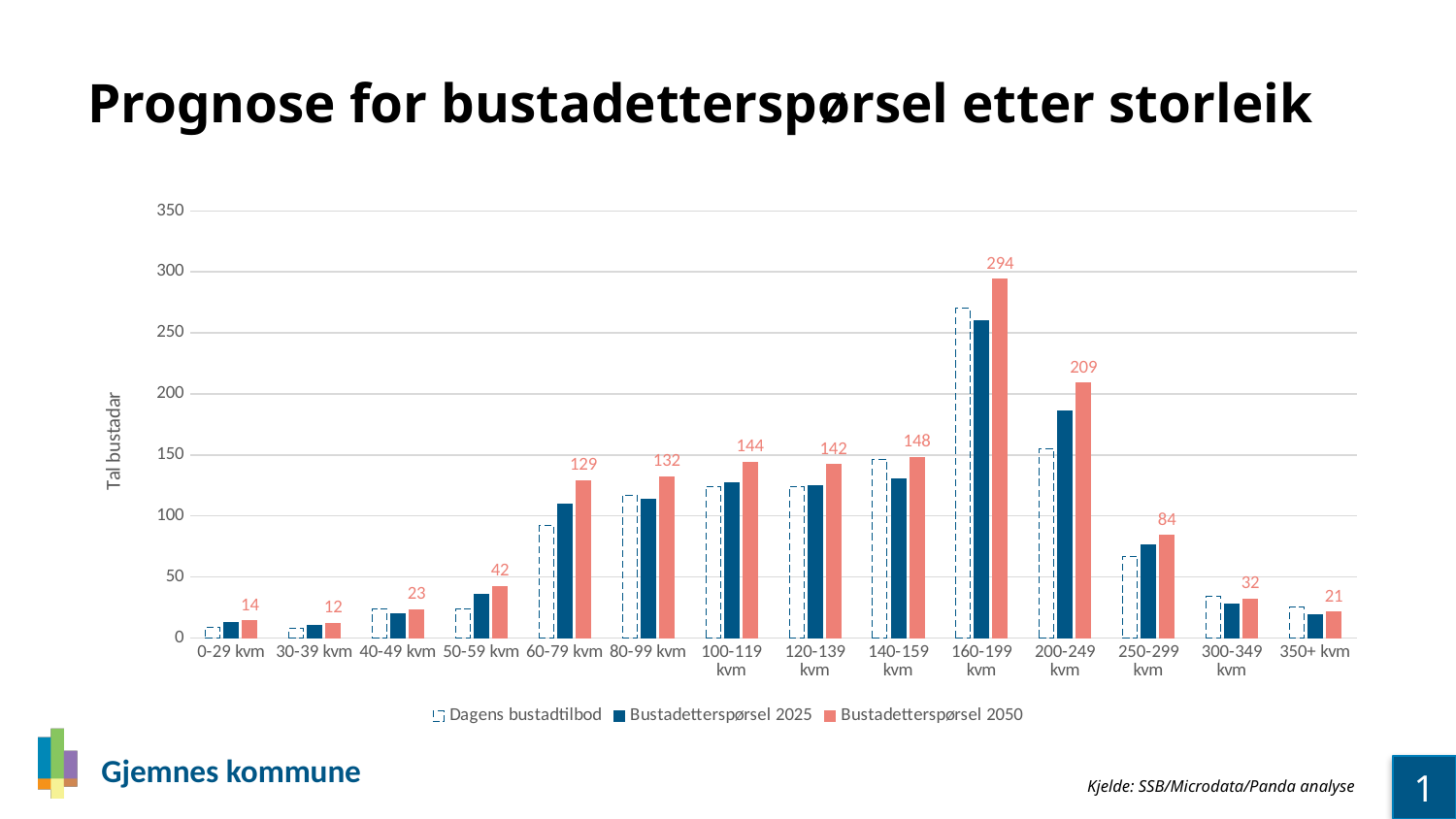
Which size category has the highest Bustadetterspørsel 2050 value? 160-199 kvm What is the Bustadetterspørsel 2050 value for 160-199 kvm? 294 What is the Bustadetterspørsel 2050 value for 350+ kvm? 21 What is the difference between the Bustadetterspørsel 2050 values for 160-199 kvm and 200-249 kvm? 85 What type of chart is shown on the slide? Bar chart Is the Dagens bustadtilbod value for 200-249 kvm greater or less than 200? less What is the Bustadetterspørsel 2050 value for 60-79 kvm? 129 Which is larger, the Bustadetterspørsel 2050 value for 250-299 kvm or for 50-59 kvm? 250-299 kvm Is the Bustadetterspørsel 2025 value for 160-199 kvm greater or less than 250? greater Which size category has the lowest Bustadetterspørsel 2050 value? 30-39 kvm How many series does the legend list? 3 How many size categories are shown on the x axis? 14